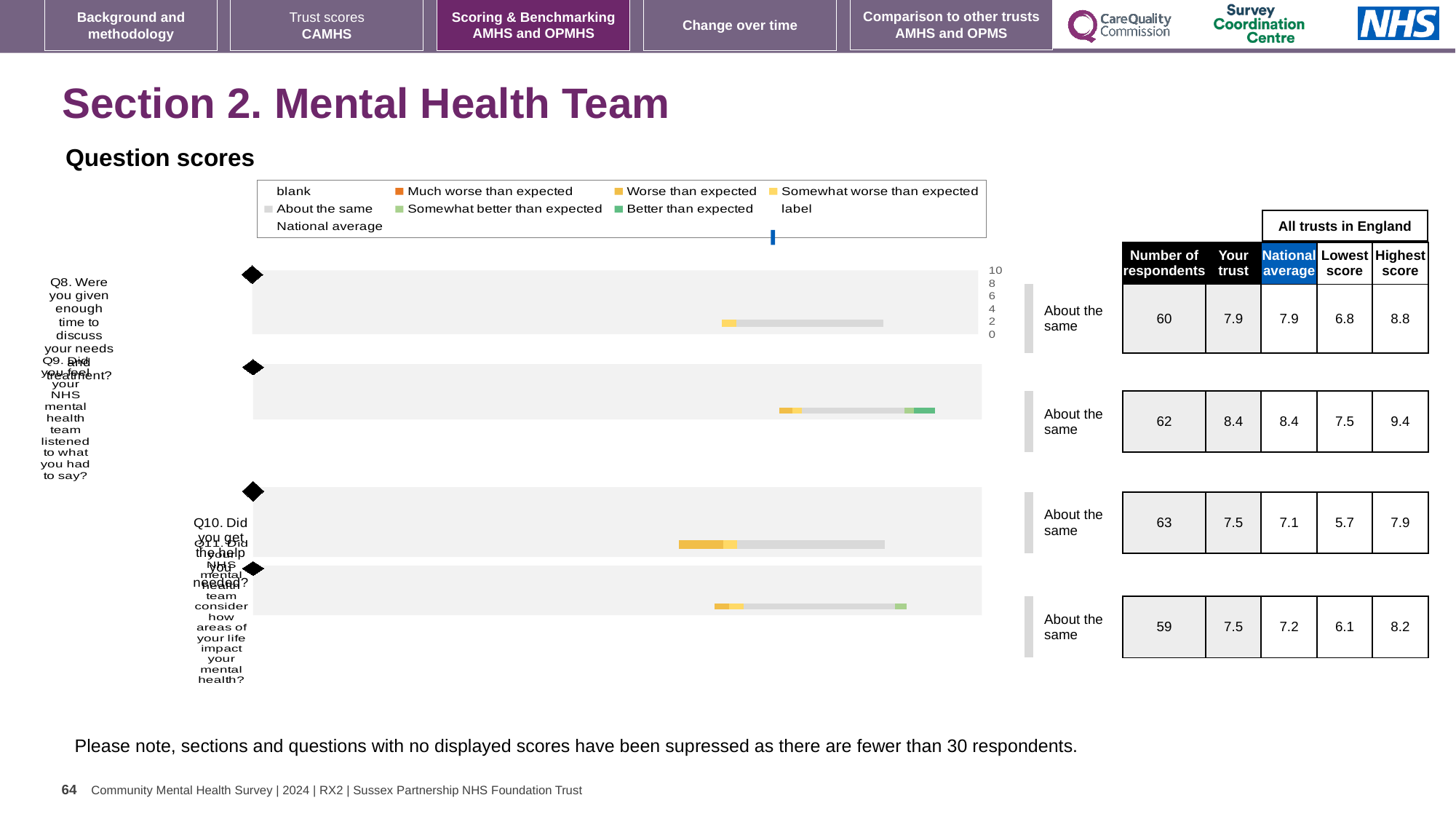
For Q10, is the 'Your trust' score higher or lower than the national average? higher Which question has the highest 'Your trust' score? Q9 What kind of chart is used to show the question scores? bar chart What is the 'Your trust' score for Q9? 8.4 What is the highest score among all trusts in England for Q11? 8.2 What is the national average score for Q10? 7.1 Which question has the lowest 'Lowest score' value? Q10 What is the difference between the highest score and the lowest score for Q9? 1.9 How many questions are plotted in the question scores chart? 4 What is the number of respondents for Q8? 60 What benchmark label is shown next to each of the four question bars? About the same